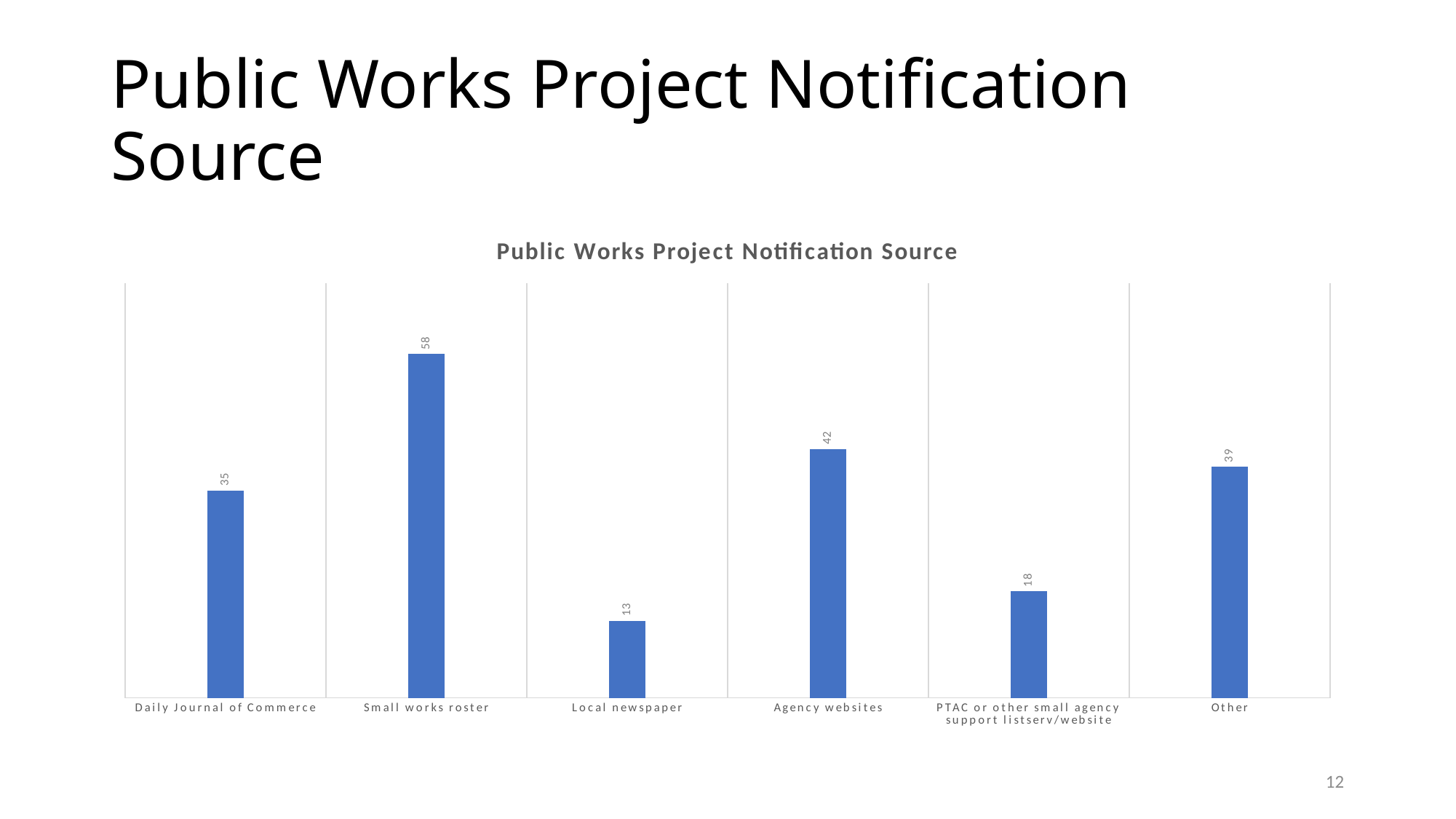
How many categories are shown on the x axis? 6 What is the value for Small works roster? 58 Which is larger, the value for Agency websites or the value for Other? Agency websites What is the value for Other? 39 What is the value for PTAC or other small agency support listserv/website? 18 What is the difference between the values for Small works roster and Agency websites? 16 What is the title of the chart? Public Works Project Notification Source What is the difference between the values for Daily Journal of Commerce and Local newspaper? 22 Which category has the lowest value? Local newspaper What is the value for Local newspaper? 13 Which category has the highest value? Small works roster What kind of chart is shown on the slide? Bar chart